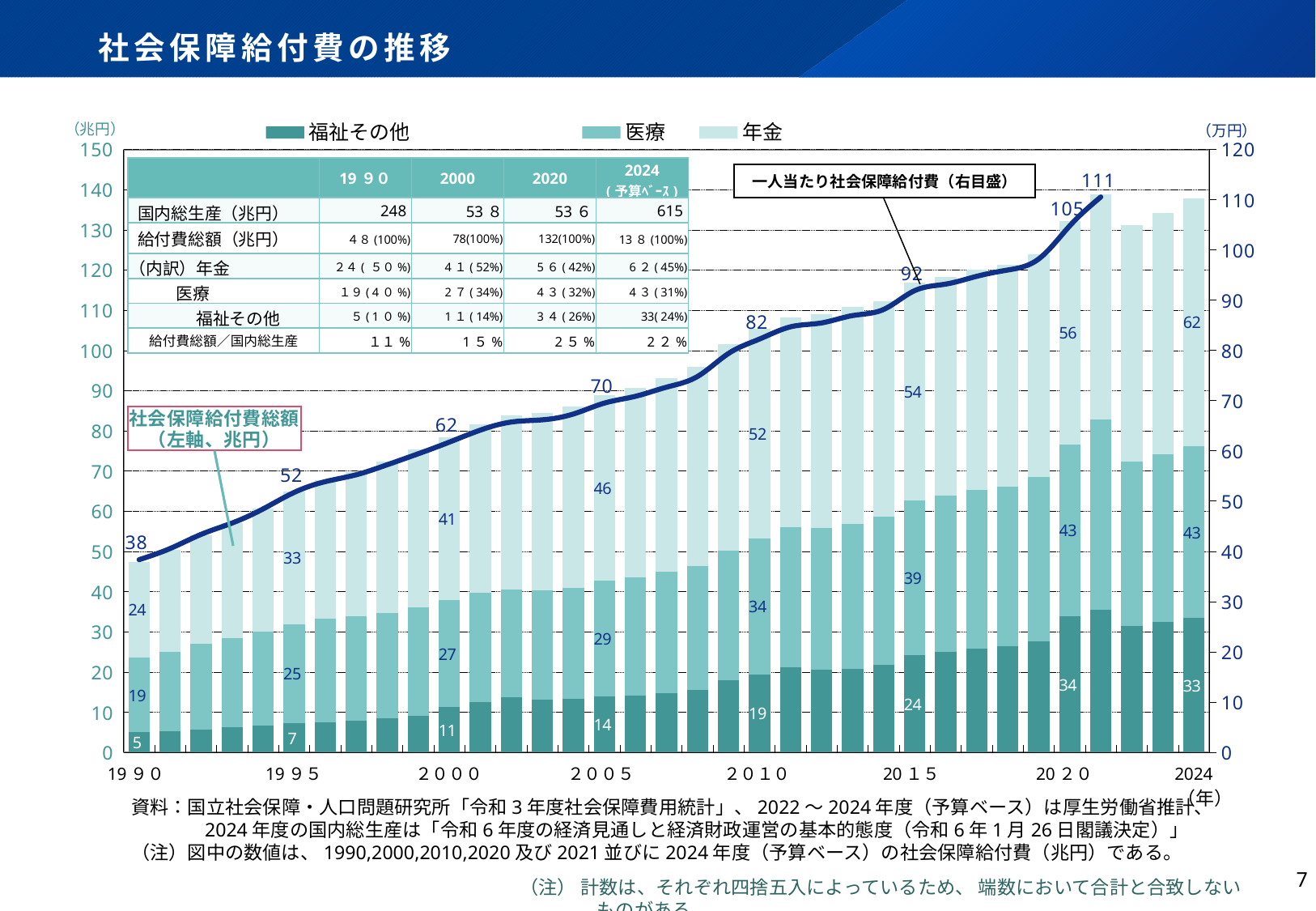
Does the 一人当たり社会保障給付費 line rise or fall from 1990 to 2021? Rise What is the value of the 福祉その他 segment for 2024? 33 What is the value of the 医療 segment for 2000? 27 What is the difference between the 年金 and 医療 segments in 2024? 19 What is the highest labelled value on the 一人当たり社会保障給付費 line? 111 What is the total of the stacked bar for 2024 (福祉その他 + 医療 + 年金)? 138 What is the value of the 年金 segment for 1990? 24 How many series does the legend list for the stacked bars? 3 What is the total of the stacked bar for 1990 (福祉その他 + 医療 + 年金)? 48 Which segment is larger in 2024, 年金 or 福祉その他? 年金 What is the per-capita social security benefit (一人当たり社会保障給付費, right axis) shown for 1990? 38 What kind of chart is used to show the 社会保障給付費総額 by category? Stacked bar chart